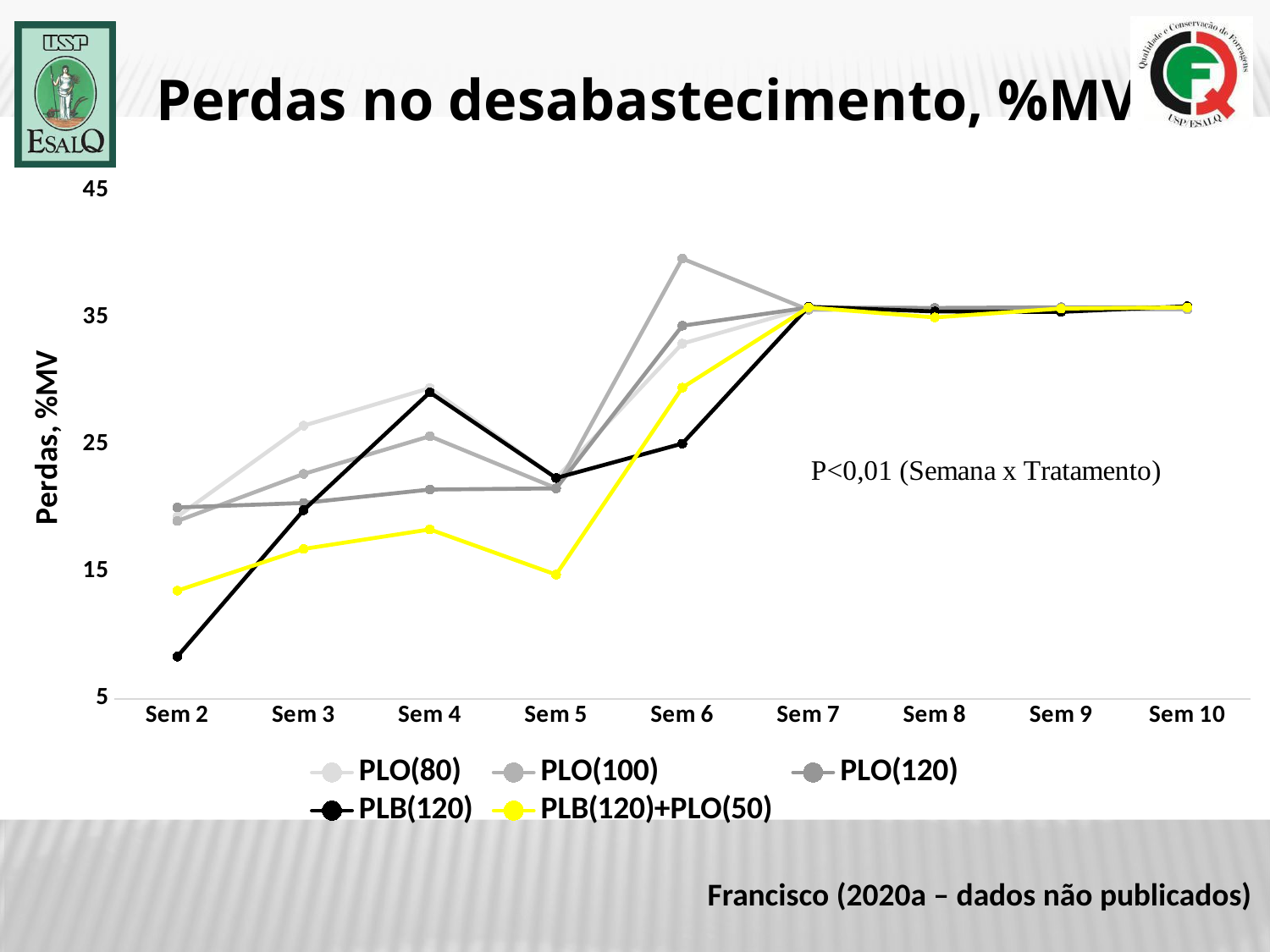
Which series has the lowest value at Sem 2? PLB(120) What kind of chart is shown on the slide? Line chart Which series has the lowest value at Sem 5? PLB(120)+PLO(50) Is the value for PLO(120) at Sem 4 greater or less than 25? less How many weeks (Sem) are shown along the x axis? 9 Is the value for PLB(120) at Sem 2 greater or less than 15? less At Sem 4, which is larger: PLB(120) or PLO(120)? PLB(120) What is the label of the y axis? Perdas, %MV Does the PLB(120) series rise or fall from Sem 2 to Sem 4? Rise Is the value for PLO(100) at Sem 6 greater or less than 35? greater How many series does the legend list? 5 Which series has the highest value at Sem 6? PLO(100)